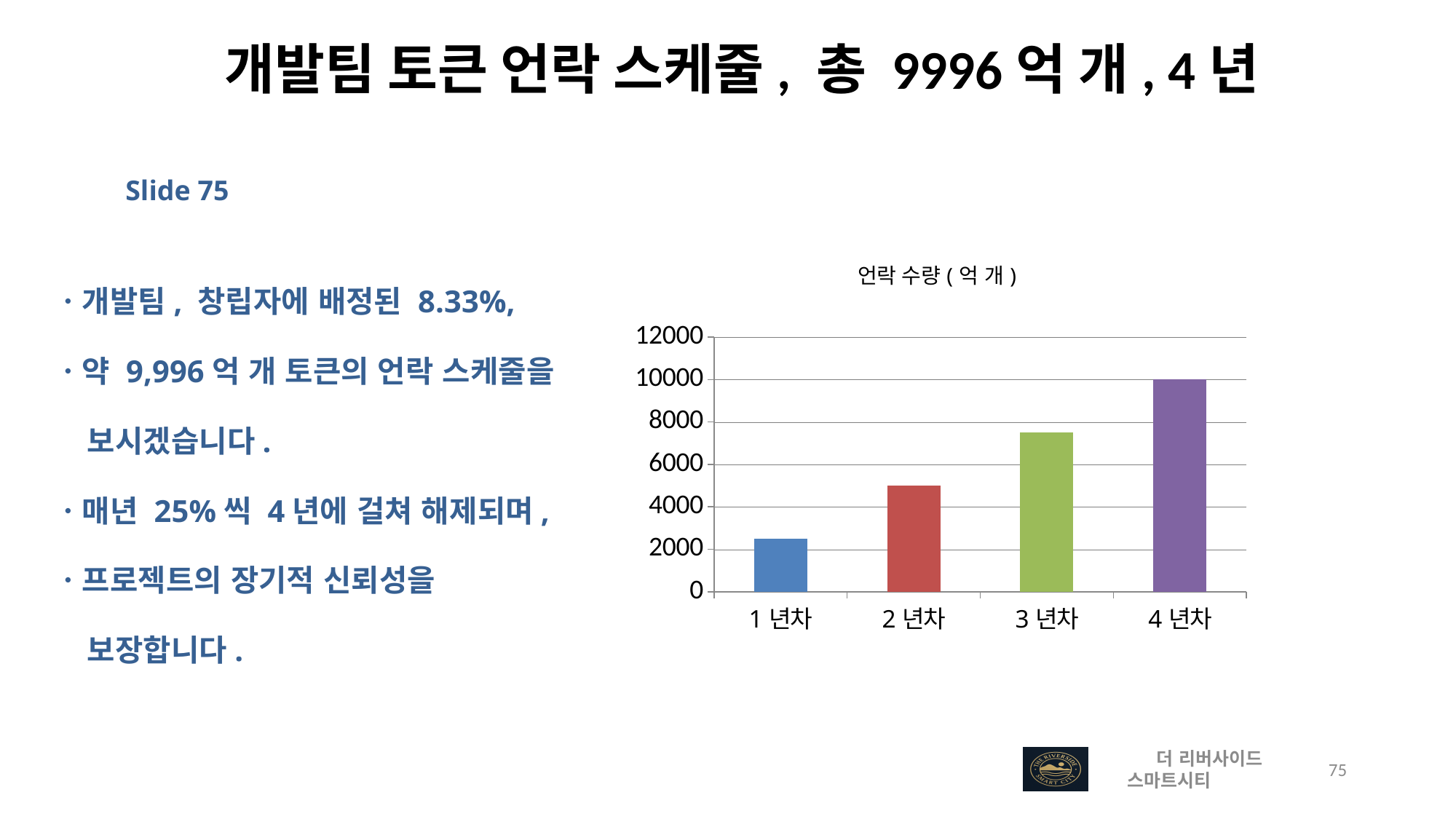
Is the value for 1 년차 greater or less than 4000? less Which is larger, the value for 2 년차 or the value for 3 년차? 3 년차 What kind of chart is shown on the slide? bar chart What is the title of the chart? 언락 수량 ( 억 개 ) Is the value for 4 년차 greater or less than 8000? greater Is the value for 3 년차 greater or less than 8000? less Do the values rise or fall from 1 년차 to 4 년차? rise Which category has the lowest value in the chart? 1 년차 Which category has the highest value in the chart? 4 년차 What is the highest value shown on the y axis of the chart? 12000 How many categories are shown on the x axis of the chart? 4